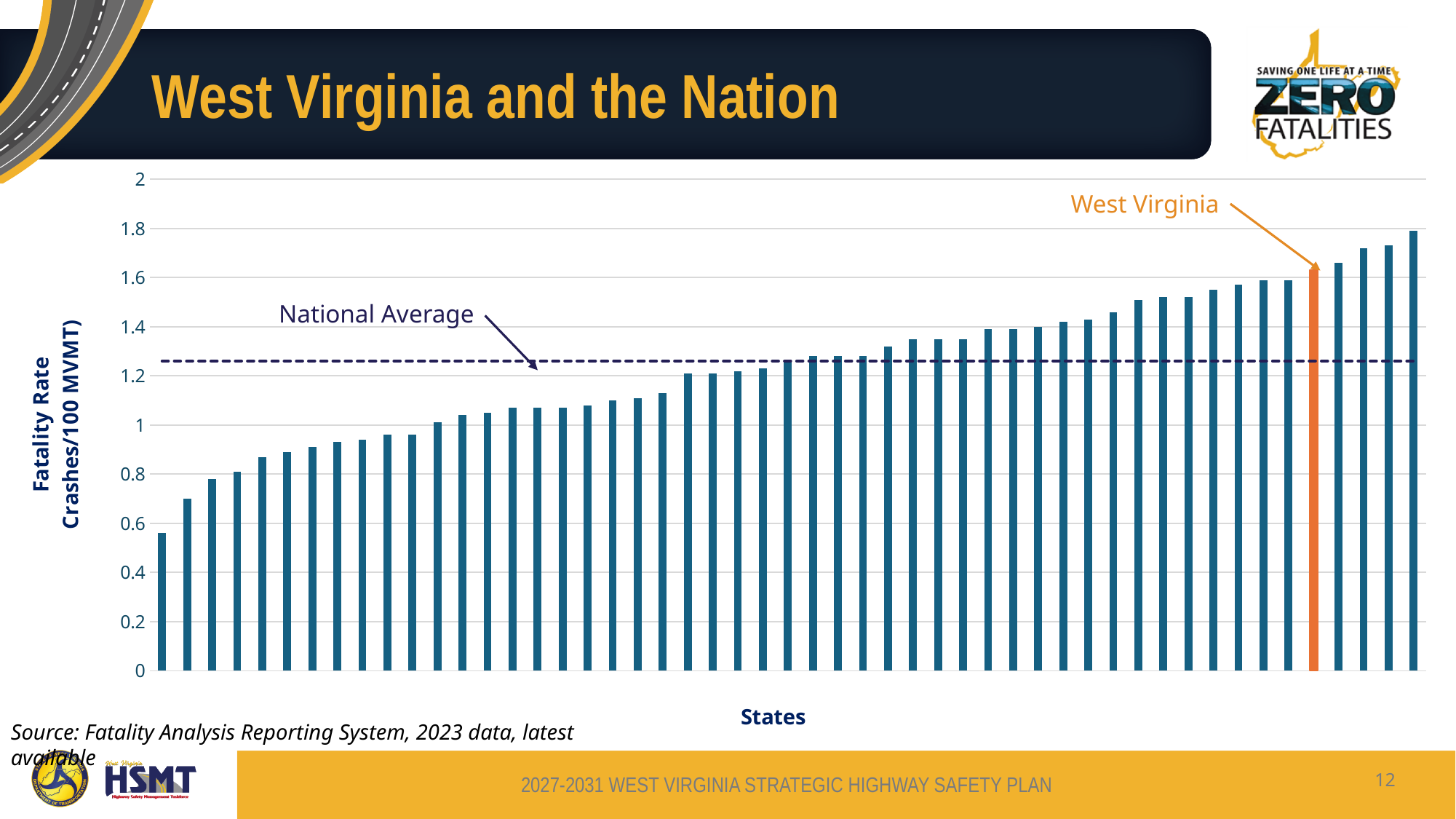
What is the label on the vertical axis of the chart? Fatality Rate Crashes/100 MVMT Is the shortest bar in the chart greater or less than 0.8? less Is West Virginia's fatality rate above or below the National Average line? above Is the fatality rate for West Virginia greater or less than 1.4? greater Is the National Average line greater or less than 1.4? less What kind of chart is shown on the slide? bar chart What does the dashed horizontal line across the chart represent? National Average Do the bar values rise or fall from left to right across the states? rise How many states have a bar taller than West Virginia's? 4